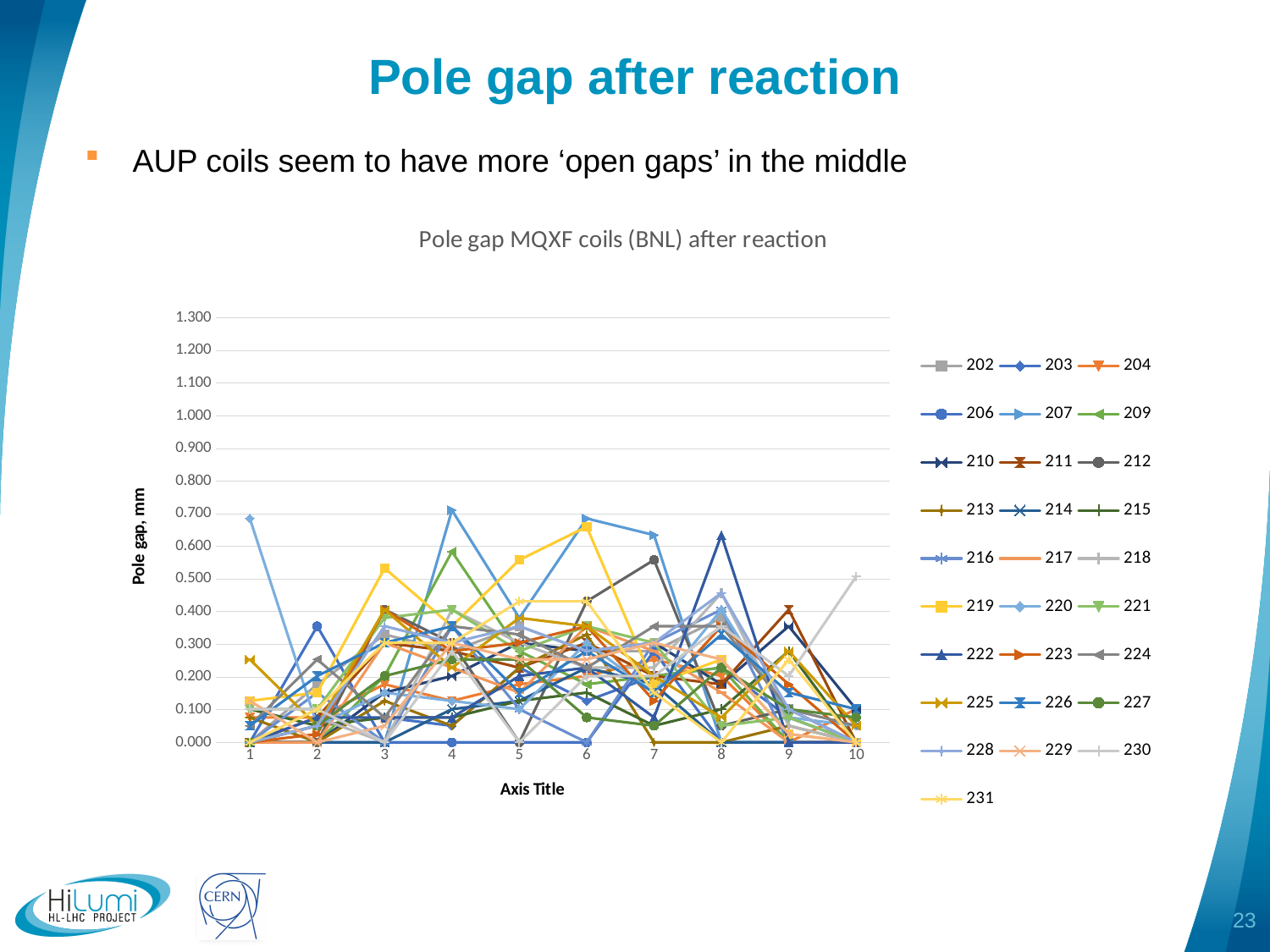
What kind of chart is shown on the slide? line chart Is the value for series 220 at x = 1 greater or less than 0.500? greater What is the label of the vertical axis? Pole gap, mm Is the value for series 219 at x = 6 greater or less than 0.500? greater Is the value for series 222 at x = 8 greater or less than 0.500? greater What is the title of the chart? Pole gap MQXF coils (BNL) after reaction How many series does the chart legend list? 28 How many points are there along the x axis of the chart? 10